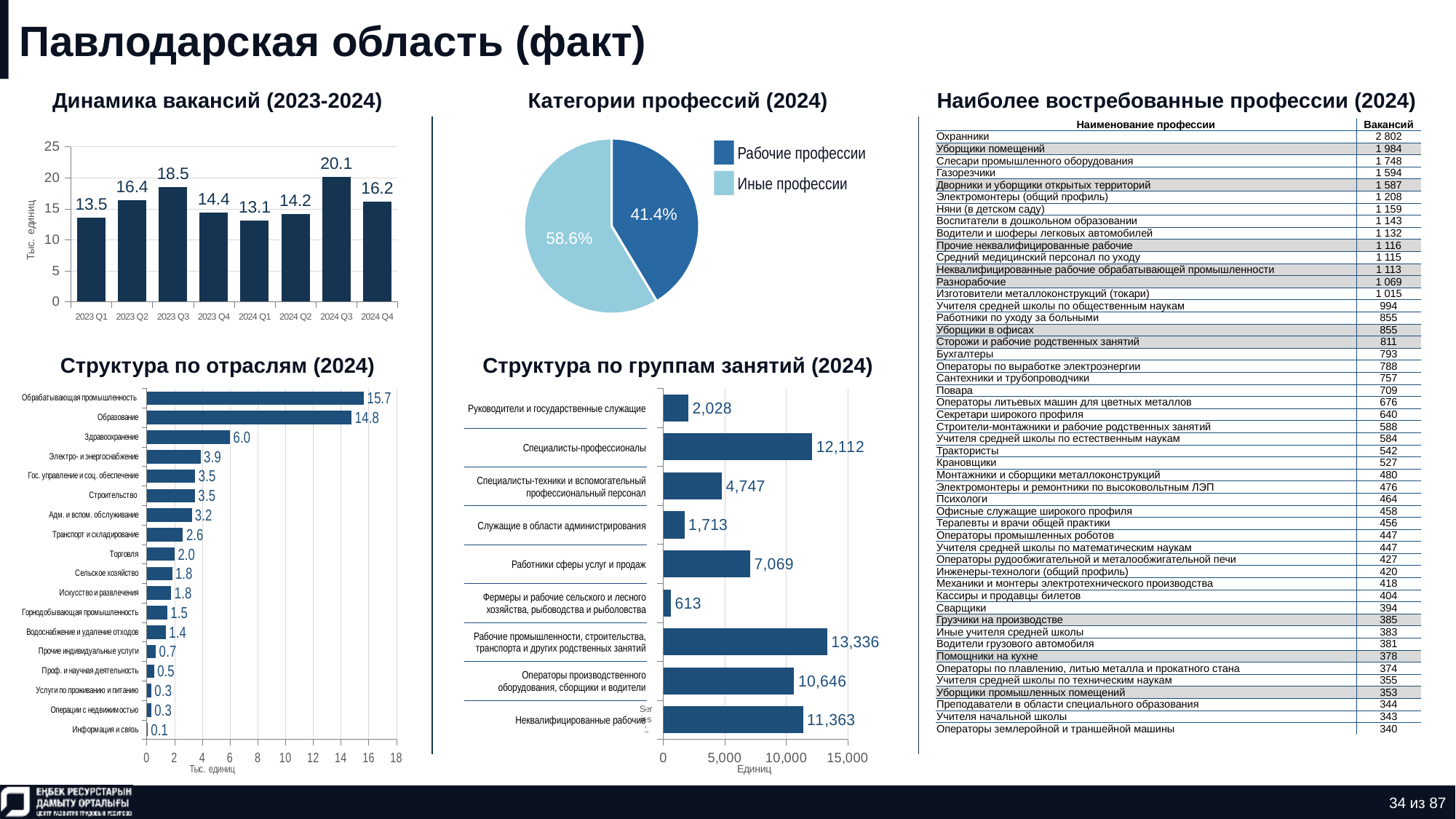
In the chart 'Категории профессий (2024)', how many entries does the legend list? 2 In the chart 'Динамика вакансий (2023-2024)', how many quarters are plotted? 8 In the chart 'Структура по группам занятий (2024)', which is larger: 'Работники сферы услуг и продаж' or 'Специалисты-техники и вспомогательный профессиональный персонал'? Работники сферы услуг и продаж In the chart 'Структура по отраслям (2024)', what is the value for 'Здравоохранение'? 6.0 In the chart 'Динамика вакансий (2023-2024)', what is the difference between 2024 Q3 and 2024 Q4? 3.9 In the chart 'Динамика вакансий (2023-2024)', which quarter has the lowest value? 2024 Q1 In the chart 'Категории профессий (2024)', what kind of chart is shown? Pie chart In the chart 'Структура по группам занятий (2024)', which category has the highest value? Рабочие промышленности, строительства, транспорта и других родственных занятий In the chart 'Структура по отраслям (2024)', which category has the highest value? Обрабатывающая промышленность In the chart 'Категории профессий (2024)', what share of the pie is 'Рабочие профессии'? 41.4% In the chart 'Динамика вакансий (2023-2024)', what is the value for 2024 Q3? 20.1 In the chart 'Структура по группам занятий (2024)', what is the value for 'Специалисты-профессионалы'? 12,112